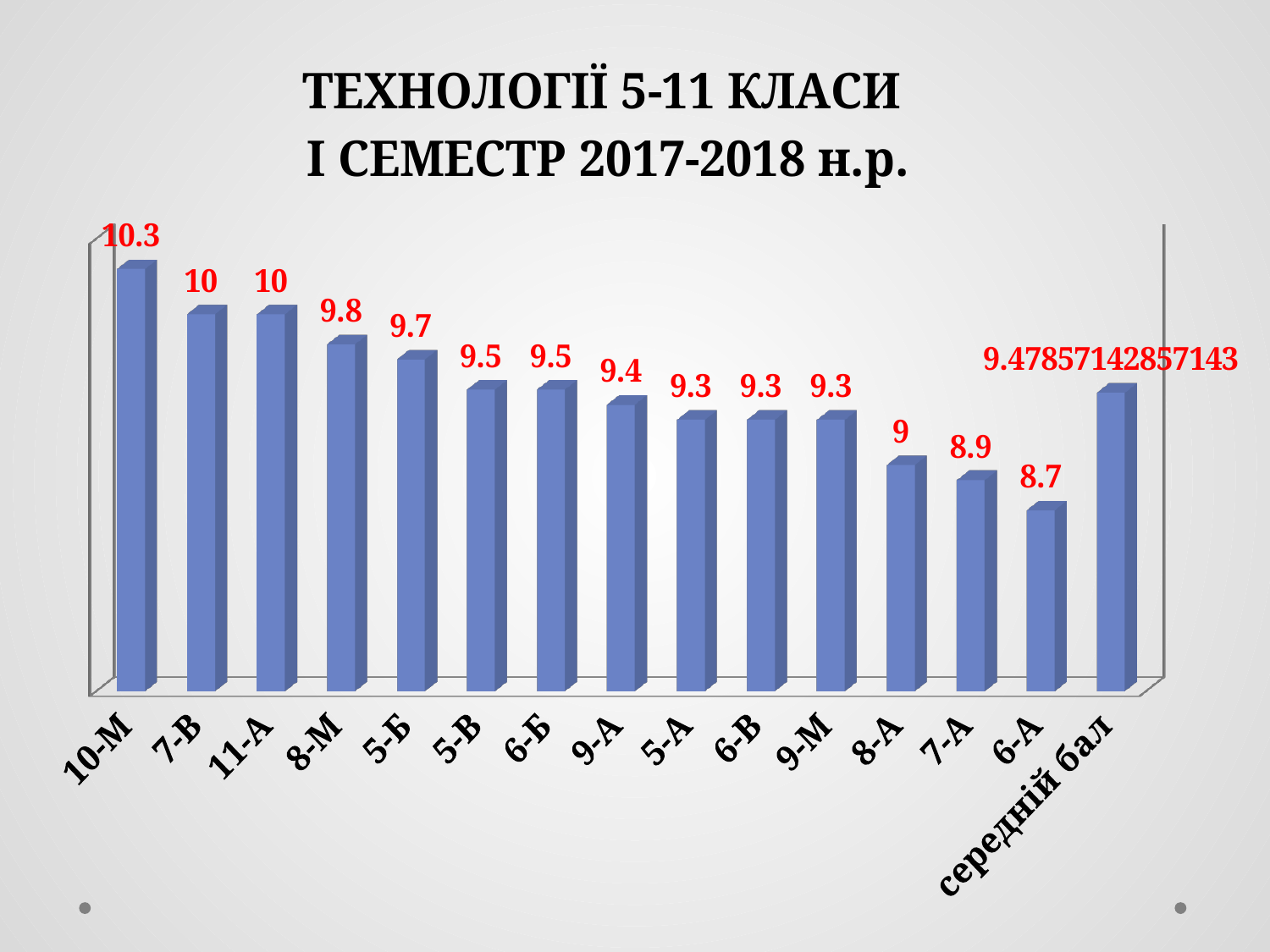
What kind of chart is shown on the slide? bar chart What is the value for 8-М? 9.8 Which is larger, the value for 5-Б or the value for 7-А? 5-Б What is the value for середній бал? 9.47857142857143 Do the class values rise or fall from 10-М to 6-А along the x axis? fall How many bars are shown in the chart? 15 Which class has the highest value? 10-М Which class has the lowest value? 6-А What is the value for 6-А? 8.7 What is the value for 10-М? 10.3 What is the difference between the values for 10-М and 6-А? 1.6 What is the title of the chart? ТЕХНОЛОГІЇ 5-11 КЛАСИ І СЕМЕСТР 2017-2018 н.р.